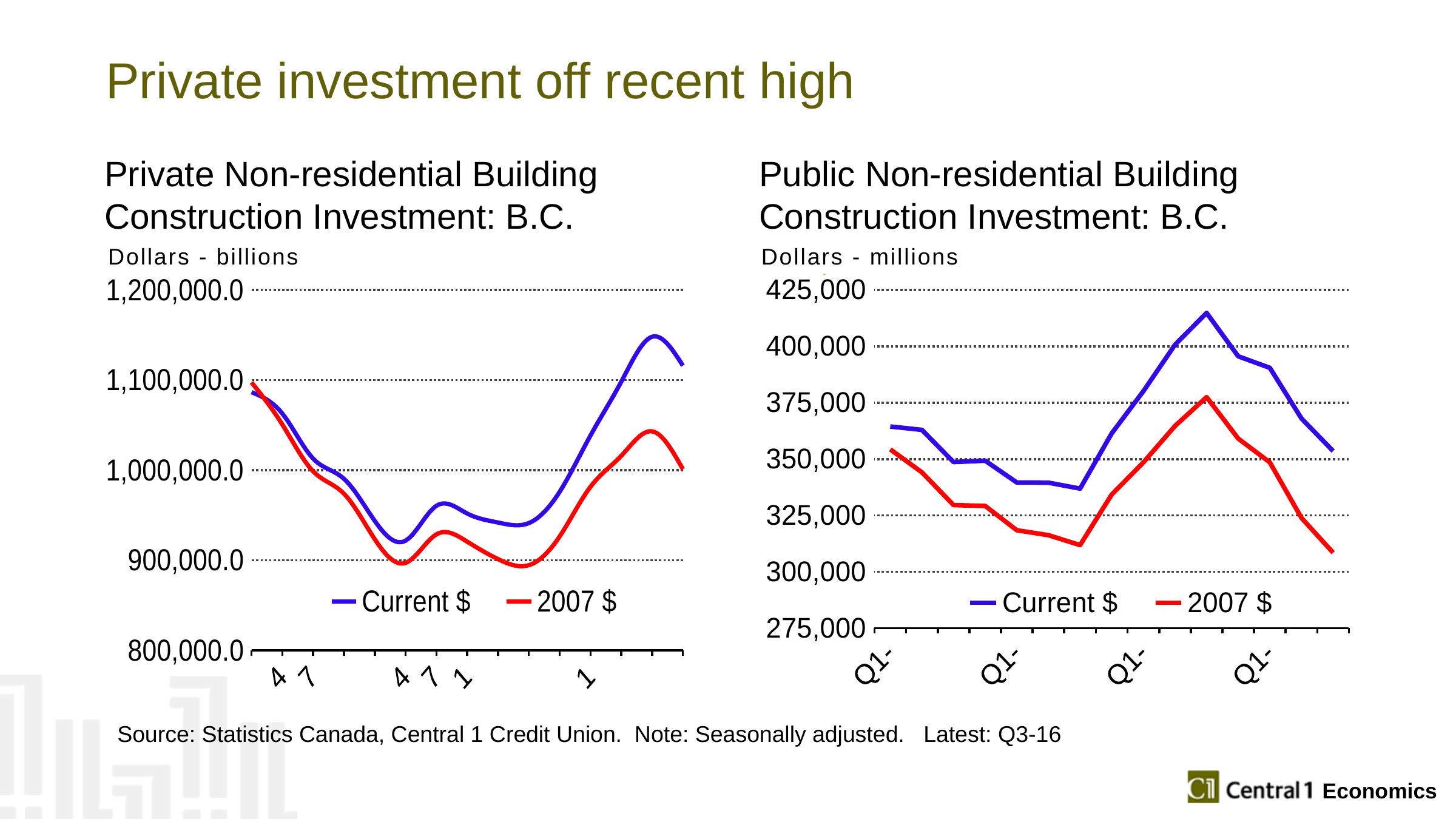
On the Private Non-residential Building Construction Investment: B.C. chart, is the final point of the 2007 $ line greater or less than 1,100,000.0? less On the Public Non-residential Building Construction Investment: B.C. chart, which series is higher at the final point, Current $ or 2007 $? Current $ On the Public Non-residential Building Construction Investment: B.C. chart, is the lowest point of the 2007 $ line greater or less than 325,000? less How many series does the legend of the Public Non-residential Building Construction Investment: B.C. chart list? 2 On the Public Non-residential Building Construction Investment: B.C. chart, does the Current $ line rise or fall from its peak to the final point? fall On the Public Non-residential Building Construction Investment: B.C. chart, is the peak of the Current $ line greater or less than 400,000? greater On the Private Non-residential Building Construction Investment: B.C. chart, which series reaches the higher peak, Current $ or 2007 $? Current $ What are the two legend entries on the Private Non-residential Building Construction Investment: B.C. chart? Current $ and 2007 $ What unit is shown above the y axis of the Public Non-residential Building Construction Investment: B.C. chart? Dollars - millions What kind of chart is the Private Non-residential Building Construction Investment: B.C. chart? line chart